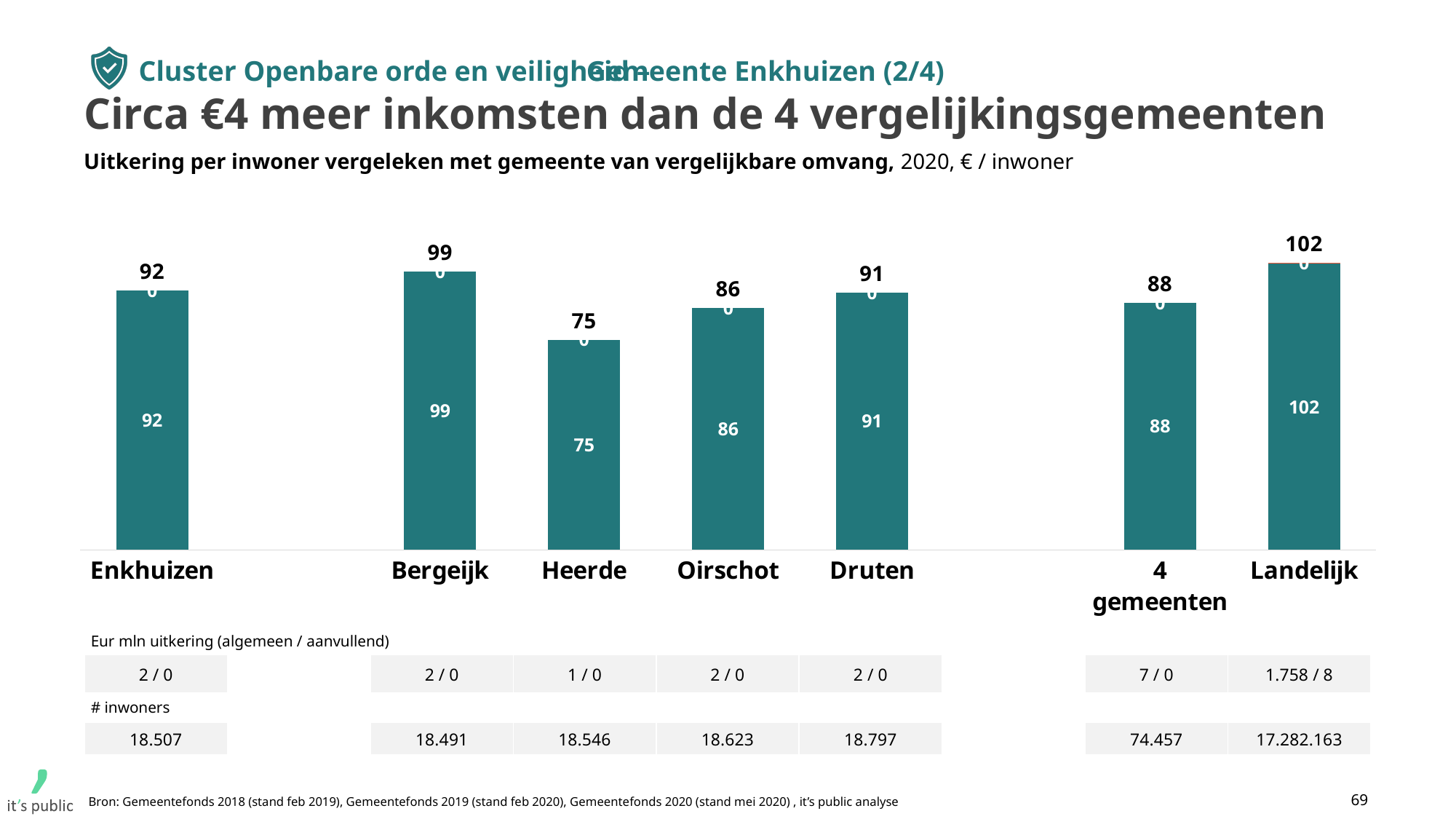
What is the value for Enkhuizen? 92 What kind of chart is shown on the slide? Bar chart Which category has the lowest value? Heerde What unit is given in the chart subtitle? € / inwoner What is the difference between the values for Enkhuizen and 4 gemeenten? 4 How many bars are shown in the chart? 7 What is the value for 4 gemeenten? 88 Which category has the highest value? Landelijk Which is larger, the value for Oirschot or the value for Druten? Druten What is the value for Landelijk? 102 What is the value for Heerde? 75 What is the difference between the values for Bergeijk and Heerde? 24